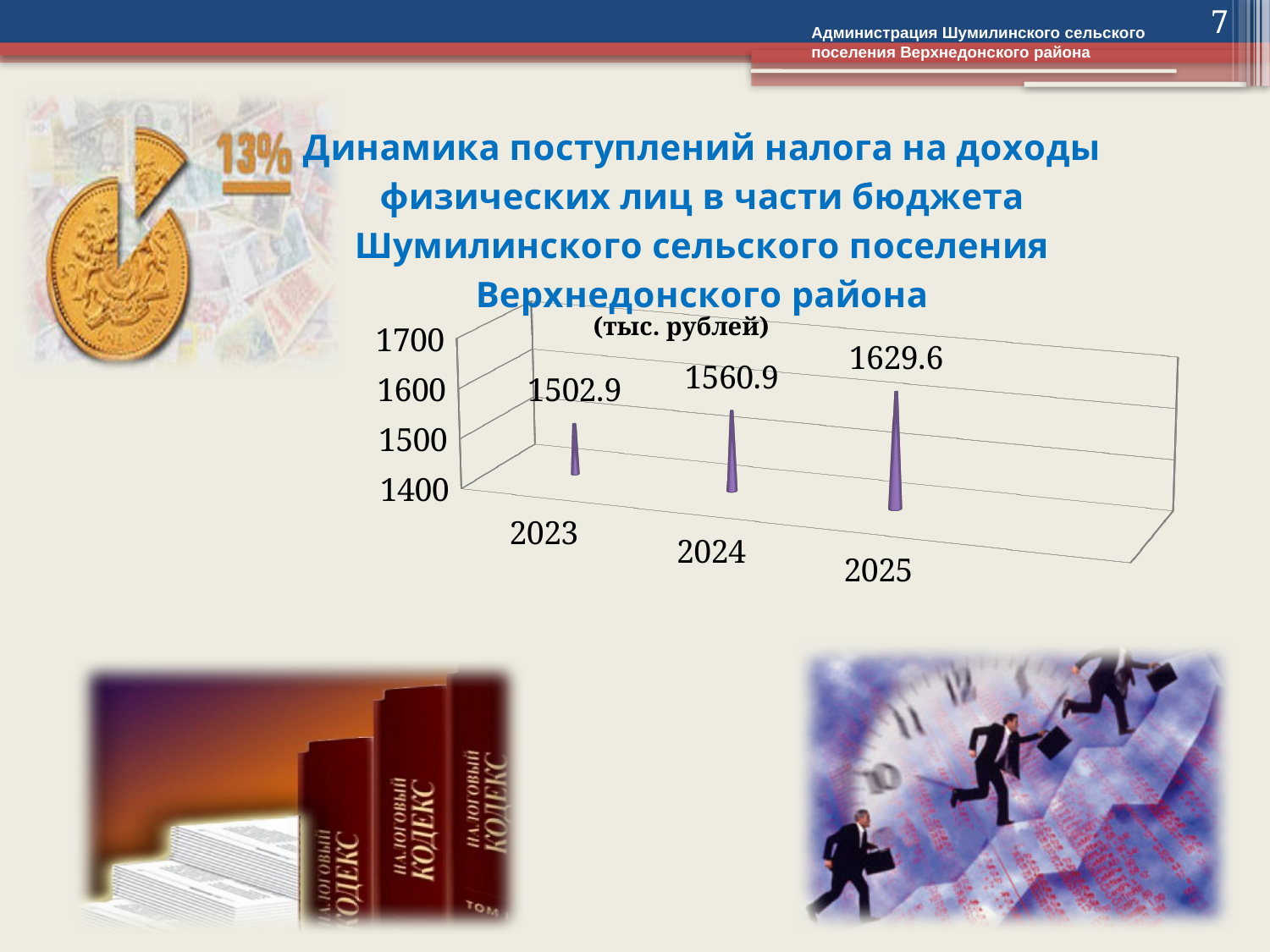
What is the value for 2024? 1560.9 Do the values rise or fall from 2023 to 2025? rise What is the difference between the values for 2025 and 2023? 126.7 What is the value for 2025? 1629.6 Which is larger, the value for 2024 or the value for 2025? 2025 What is the difference between the values for 2024 and 2023? 58.0 Which year has the lowest value? 2023 Which year has the highest value? 2025 What is the value for 2023? 1502.9 How many years are shown on the chart? 3 What unit is stated above the chart? тыс. рублей Is the value for 2025 greater or less than 1600? greater